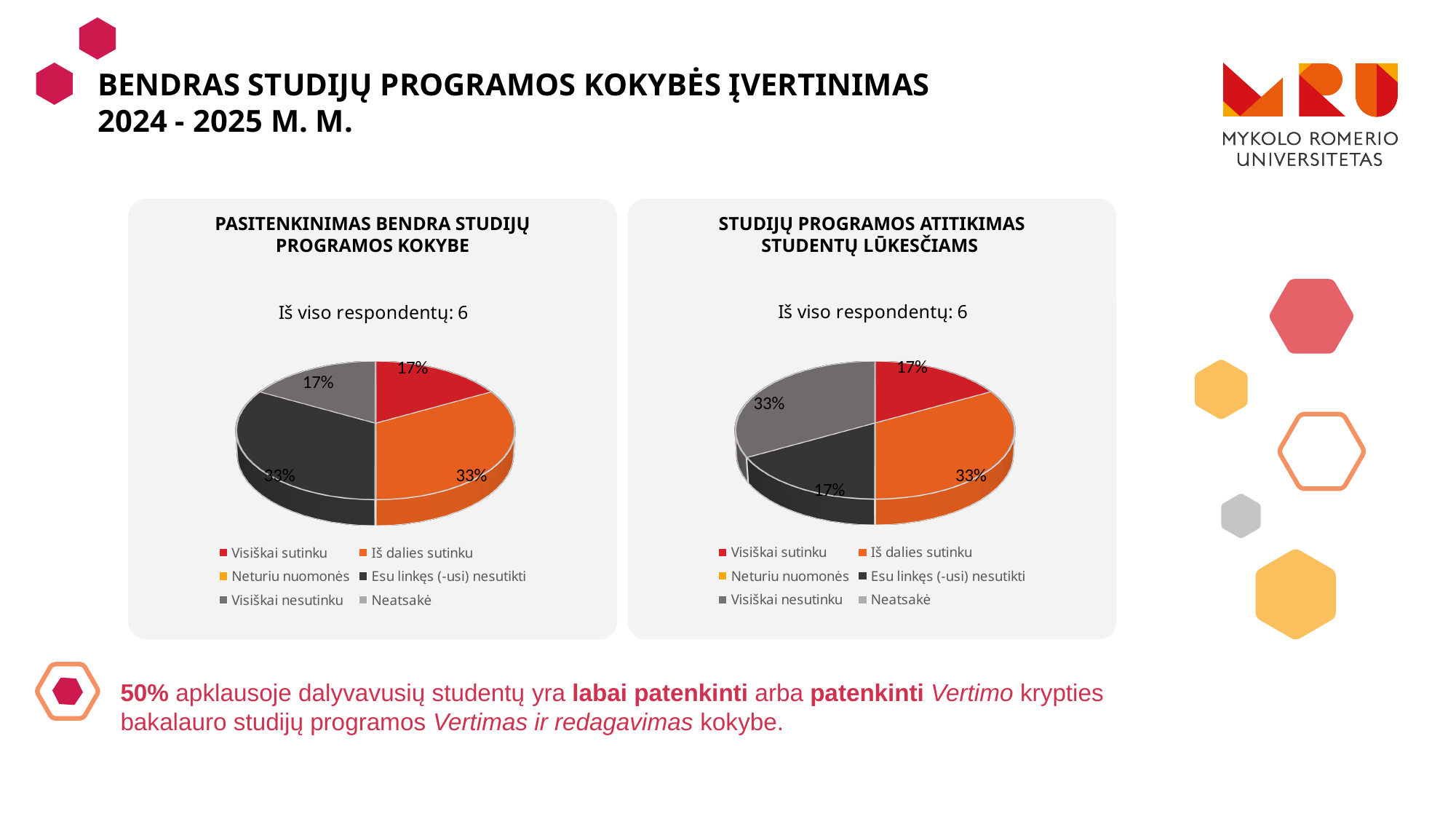
In the right chart (STUDIJŲ PROGRAMOS ATITIKIMAS STUDENTŲ LŪKESČIAMS), which is larger: "Iš dalies sutinku" or "Visiškai sutinku"? Iš dalies sutinku How many respondents in total does the left chart (PASITENKINIMAS BENDRA STUDIJŲ PROGRAMOS KOKYBE) report? 6 How many slices does the right chart (STUDIJŲ PROGRAMOS ATITIKIMAS STUDENTŲ LŪKESČIAMS) have? 4 In the right chart (STUDIJŲ PROGRAMOS ATITIKIMAS STUDENTŲ LŪKESČIAMS), what share is "Visiškai sutinku"? 17% In the left chart (PASITENKINIMAS BENDRA STUDIJŲ PROGRAMOS KOKYBE), what share is "Visiškai sutinku"? 17% What kind of chart is shown on the left under "PASITENKINIMAS BENDRA STUDIJŲ PROGRAMOS KOKYBE"? Pie chart In the right chart (STUDIJŲ PROGRAMOS ATITIKIMAS STUDENTŲ LŪKESČIAMS), what share is "Iš dalies sutinku"? 33% How many entries does the legend of the left chart (PASITENKINIMAS BENDRA STUDIJŲ PROGRAMOS KOKYBE) list? 6 In the left chart (PASITENKINIMAS BENDRA STUDIJŲ PROGRAMOS KOKYBE), what is the difference between the "Iš dalies sutinku" share and the "Visiškai sutinku" share? 16%